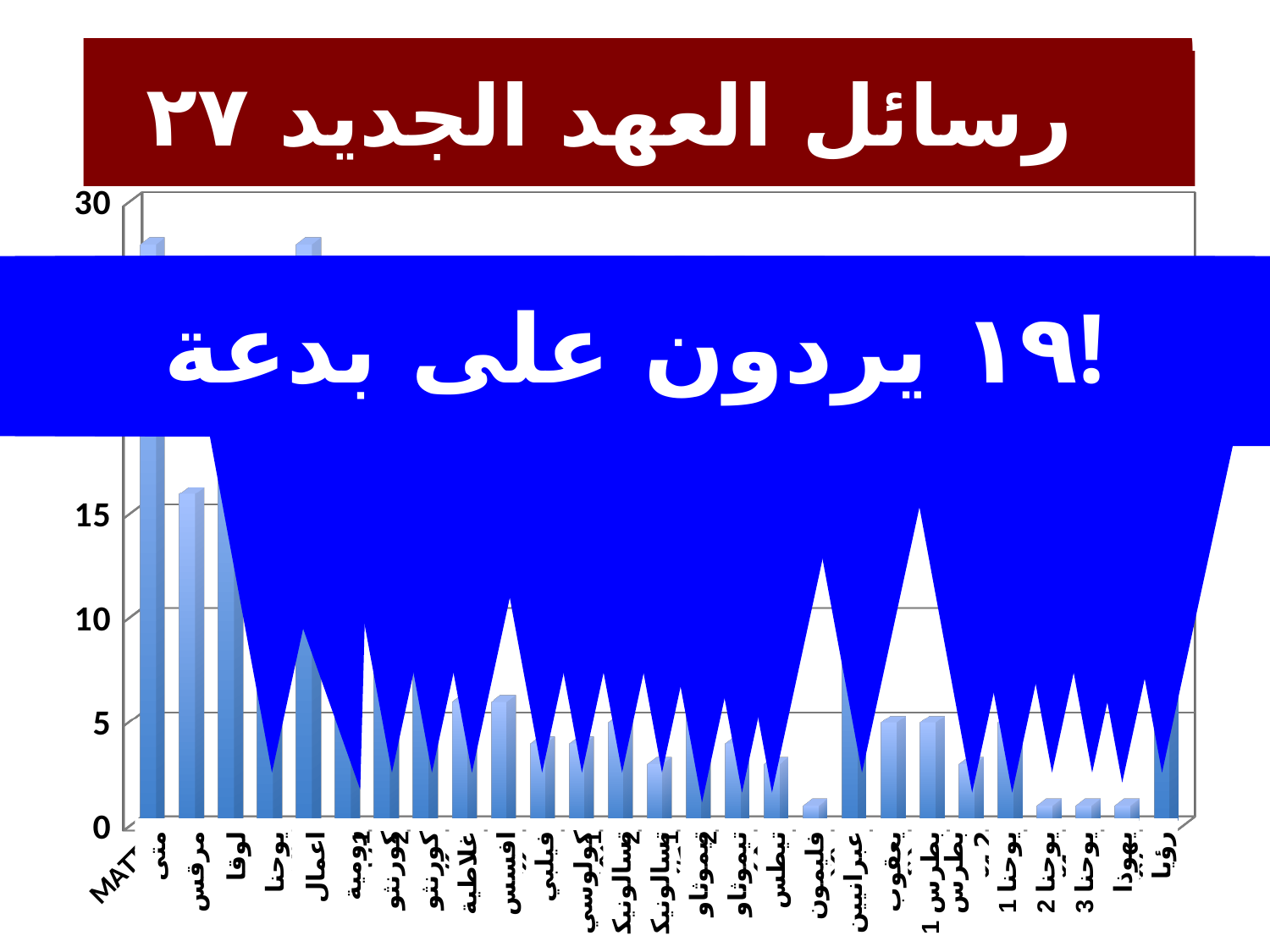
Is the value for غلاطية greater or less than 10? less Which has the larger value, عبرانيين or فليمون? عبرانيين Which has the larger value, رؤيا or 3يوحنا? رؤيا Is the value for فليمون greater or less than 5? less What kind of chart is shown on the slide? bar chart Which has the larger value, مرقس or غلاطية? مرقس What is the title shown above the chart? رسائل العهد الجديد ٢٧ Is the value for يهوذا greater or less than 5? less What is the highest value shown on the vertical axis? 30